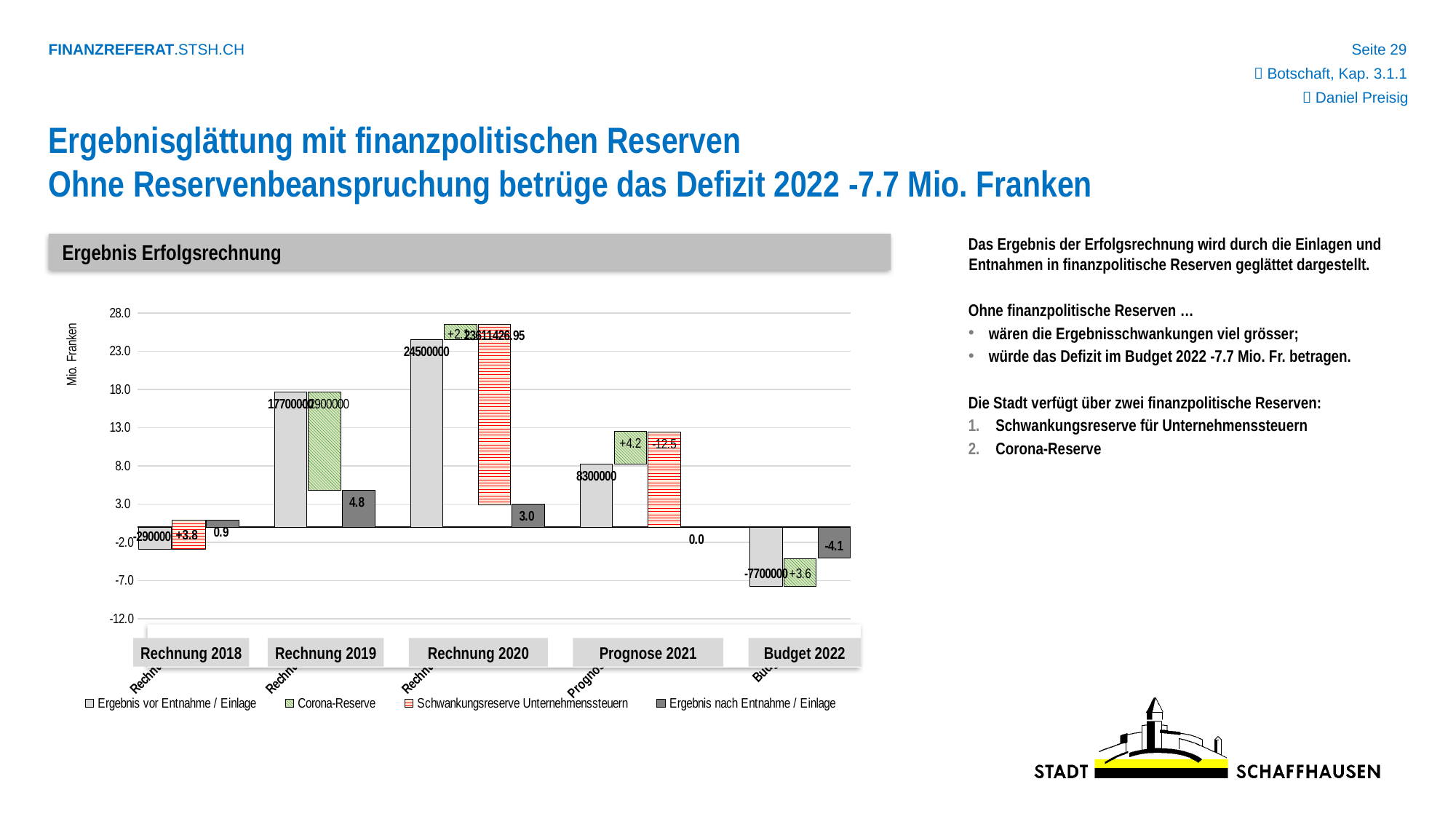
What is the value of "Ergebnis nach Entnahme / Einlage" for Rechnung 2019? 4.8 How many categories are shown along the x axis of the chart? 5 How many series does the chart legend list? 4 Which is larger: the "Ergebnis nach Entnahme / Einlage" value for Rechnung 2018 or for Rechnung 2020? Rechnung 2020 Which category has the highest "Ergebnis nach Entnahme / Einlage" value? Rechnung 2019 What is the value of "Ergebnis nach Entnahme / Einlage" for Prognose 2021? 0.0 What is the value of "Ergebnis nach Entnahme / Einlage" for Budget 2022? -4.1 What is the difference between the "Ergebnis nach Entnahme / Einlage" values for Rechnung 2019 and Rechnung 2020? 1.8 What kind of chart is shown under the heading "Ergebnis Erfolgsrechnung"? bar chart Is the "Ergebnis vor Entnahme / Einlage" value for Rechnung 2019 greater or less than 13.0? greater Which category has the lowest "Ergebnis vor Entnahme / Einlage" value? Budget 2022 What is the value of the Corona-Reserve bar for Prognose 2021? +4.2